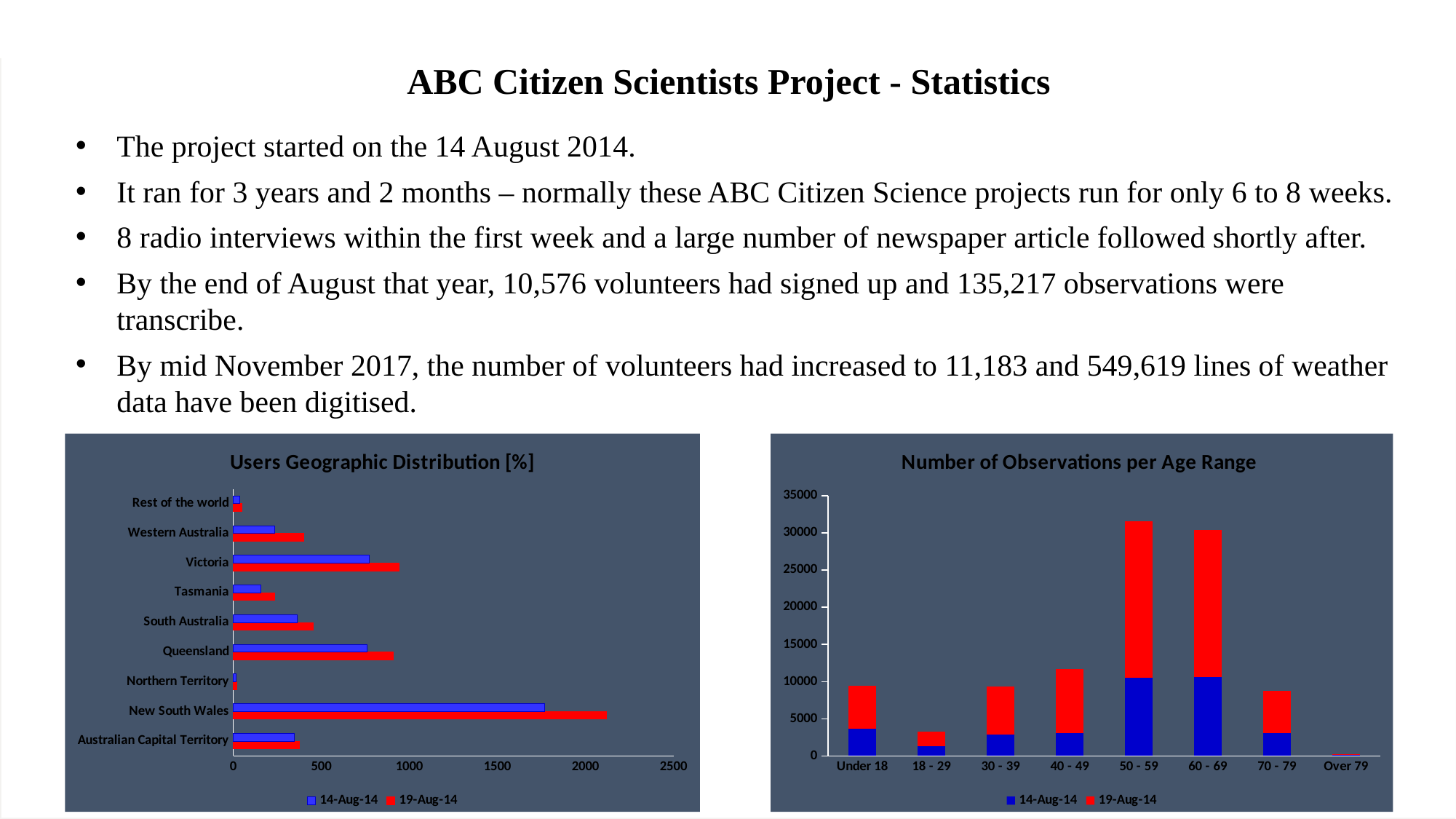
How many age ranges are shown in the 'Number of Observations per Age Range' chart? 8 What kind of chart is the 'Number of Observations per Age Range' chart on the right? stacked bar chart What kind of chart is the 'Users Geographic Distribution [%]' chart on the left? bar chart In the 'Number of Observations per Age Range' chart, is the total for the 18 - 29 age range greater or less than 5000? less In the 'Users Geographic Distribution [%]' chart, is the 19-Aug-14 value for New South Wales greater or less than 2000? greater In the 'Users Geographic Distribution [%]' chart, is the 19-Aug-14 value for Victoria greater or less than 1000? less In the 'Number of Observations per Age Range' chart, which age range has the lowest total number of observations? Over 79 In the 'Users Geographic Distribution [%]' chart, which category has the lowest value for 14-Aug-14? Northern Territory How many categories are shown in the 'Users Geographic Distribution [%]' chart? 9 In the 'Users Geographic Distribution [%]' chart, which category has the highest value for 19-Aug-14? New South Wales How many series does the legend of the 'Number of Observations per Age Range' chart list? 2 In the 'Number of Observations per Age Range' chart, which has the larger total: Under 18 or 18 - 29? Under 18